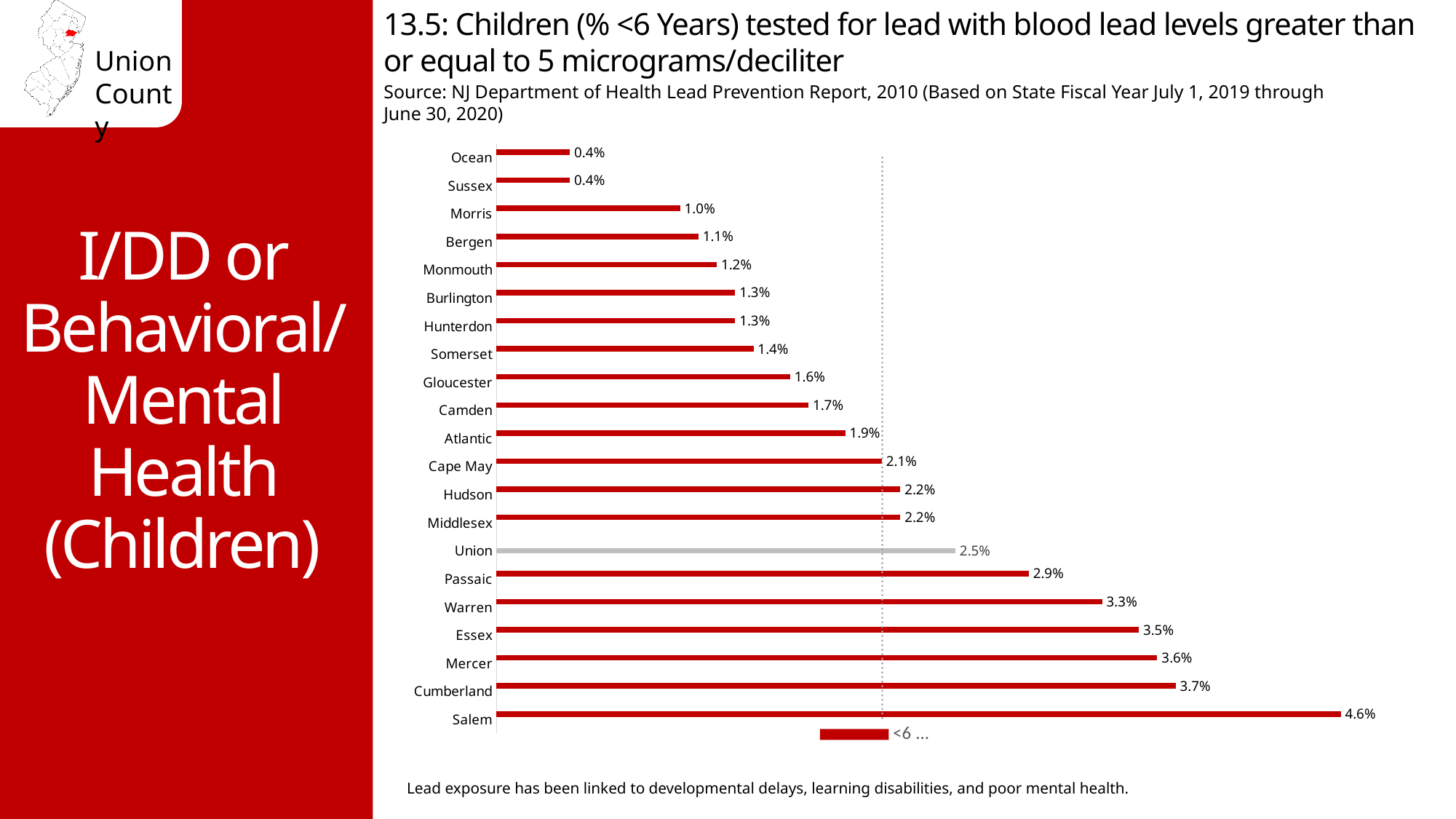
Which is larger, the value for Passaic or the value for Camden? Passaic Which is larger, the value for Bergen or the value for Mercer? Mercer What is the value for Union? 2.5% What is the value for Salem? 4.6% What is the value for Morris? 1.0% What is the value for Essex? 3.5% What is the difference between the values for Salem and Union? 2.1% What is the difference between the values for Essex and Hudson? 1.3% What kind of chart is shown on the slide? Bar chart Which county has the highest value? Salem Which county's bar is shown in grey rather than red? Union How many counties are shown in the chart? 21